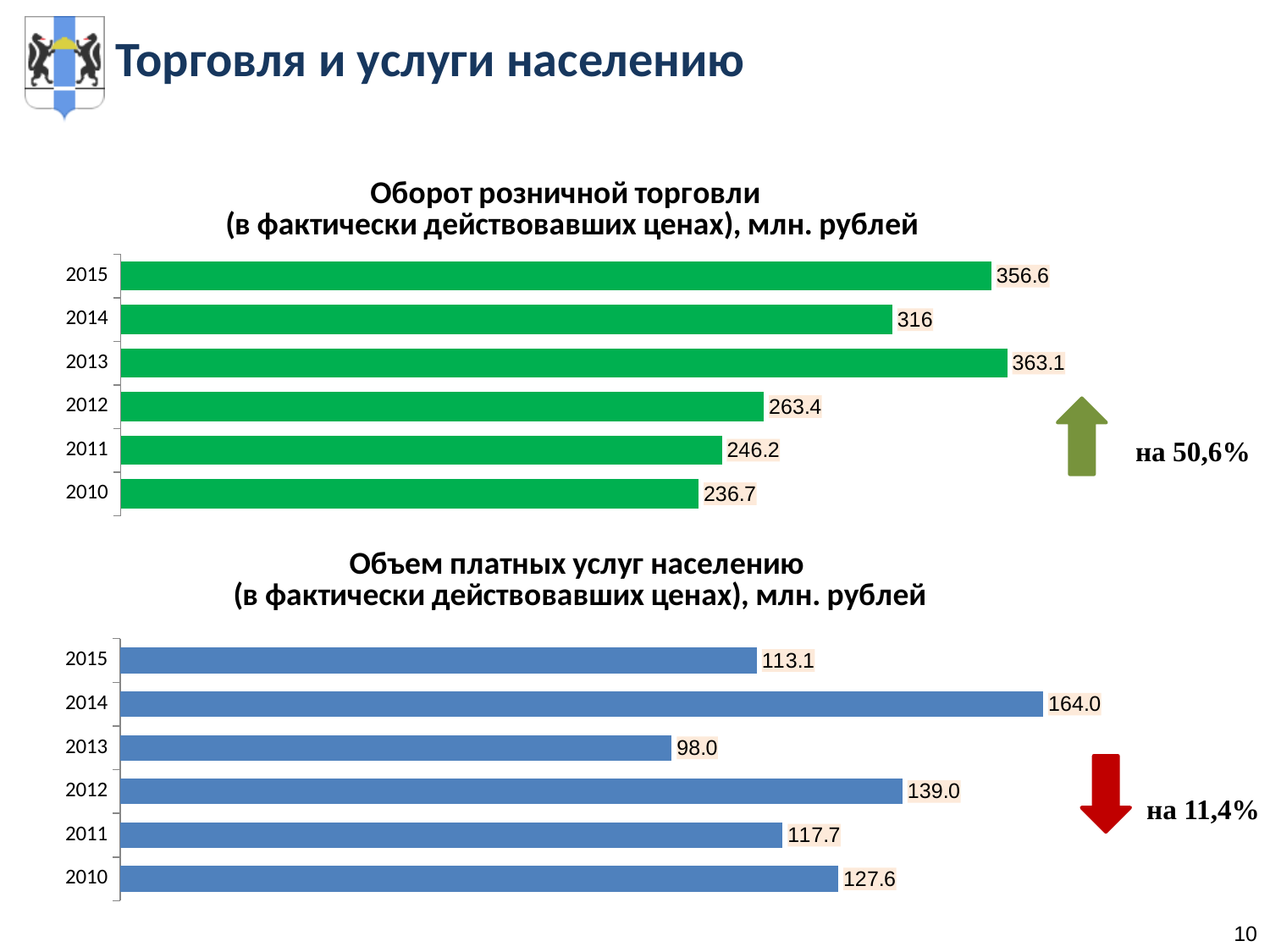
In the top chart (Оборот розничной торговли), what is the difference between the values for 2015 and 2014? 40.6 In the top chart (Оборот розничной торговли), what is the value for 2015? 356.6 In the top chart (Оборот розничной торговли), which year has the highest value? 2013 In the top chart (Оборот розничной торговли), how many years are shown? 6 What colour are the bars in the top chart (Оборот розничной торговли)? Green In the bottom chart (Объем платных услуг населению), what is the difference between the values for 2014 and 2015? 50.9 What kind of chart is the bottom chart (Объем платных услуг населению)? Bar chart In the top chart (Оборот розничной торговли), which year has the lowest value? 2010 In the top chart (Оборот розничной торговли), what is the value for 2010? 236.7 In the bottom chart (Объем платных услуг населению), which is larger, the value for 2012 or the value for 2010? 2012 In the bottom chart (Объем платных услуг населению), what is the value for 2014? 164.0 In the bottom chart (Объем платных услуг населению), which year has the lowest value? 2013